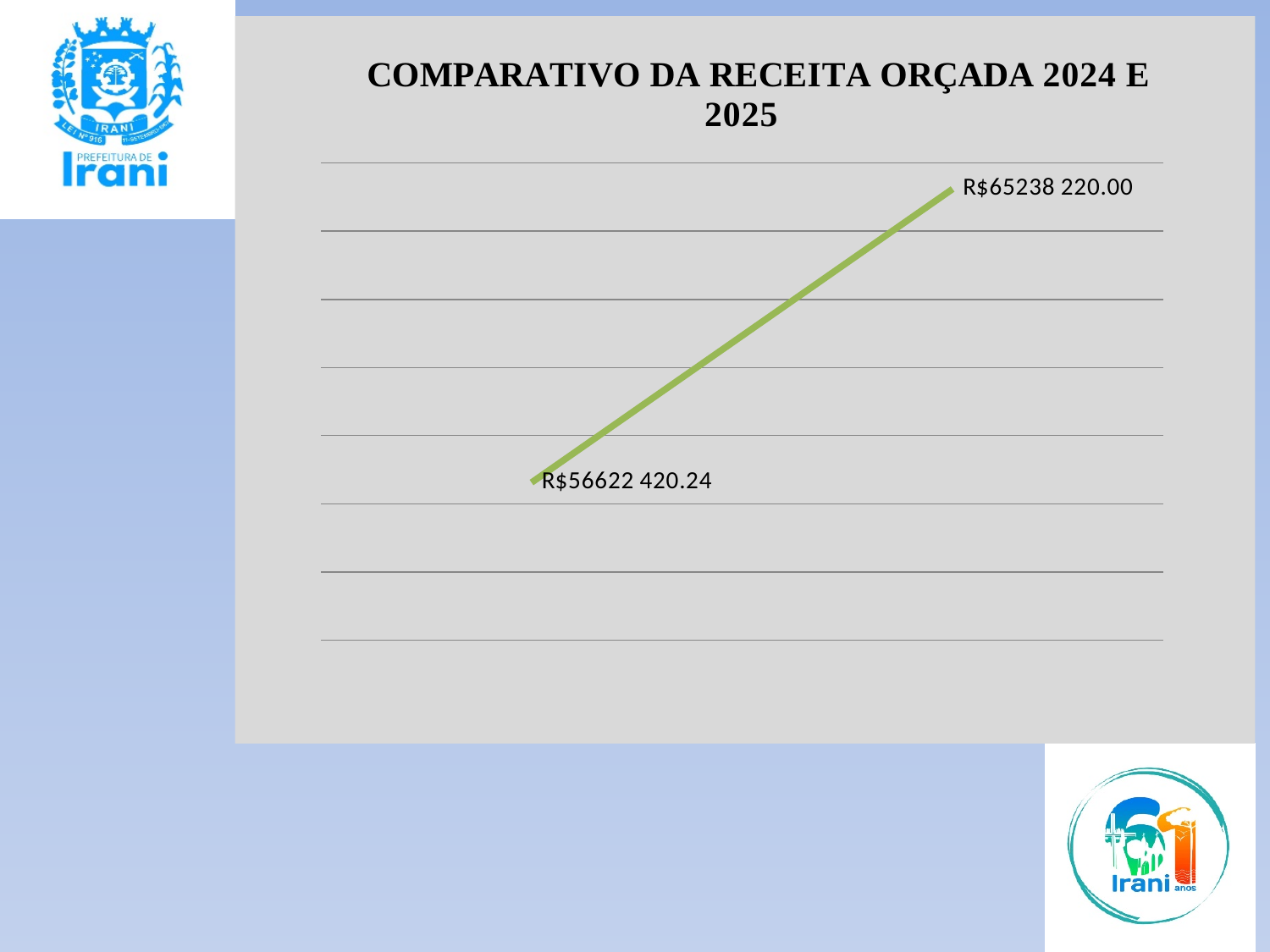
Which point on the line has the lowest value? the left (first) point Which point on the line has the highest value? the right (second) point How many data points are plotted on the line? 2 What is the data label value of the first (left) point on the line? R$56622 420.24 Which point is higher, the left point or the right point? the right point What kind of chart is shown on the slide? line chart What colour is the line in the chart? green What is the title of the chart? COMPARATIVO DA RECEITA ORÇADA 2024 E 2025 Does the line rise or fall from left to right? rises